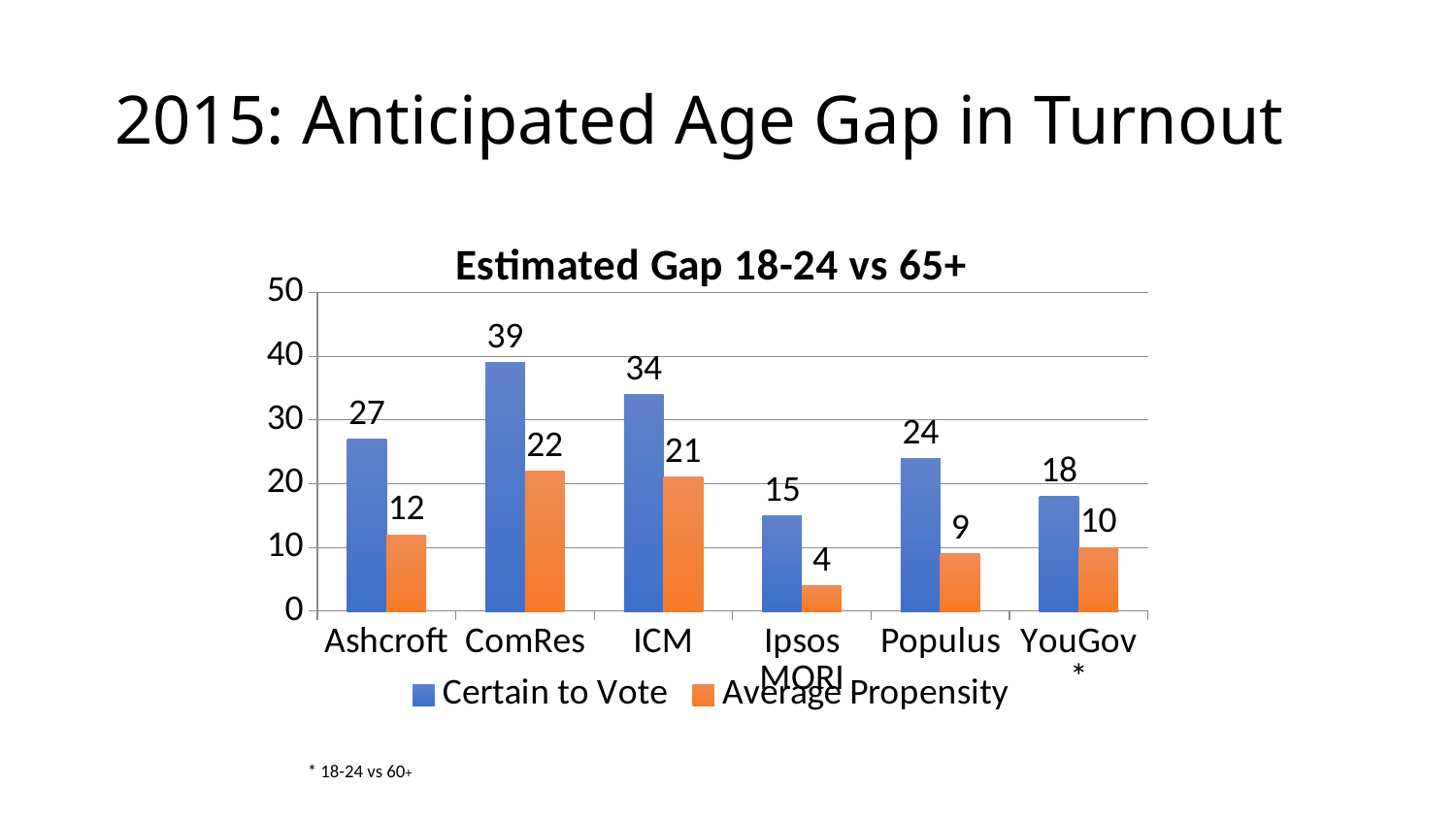
What is the Average Propensity value for Ipsos MORI? 4 What is the title of the chart? Estimated Gap 18-24 vs 65+ What is the Certain to Vote value for ComRes? 39 What is the difference between the Certain to Vote and Average Propensity values for ICM? 13 How many pollsters are shown on the x axis? 6 Which is larger, the Certain to Vote value for Ashcroft or for Populus? Ashcroft Is the Certain to Vote value for YouGov greater or less than 20? less How many series does the legend list? 2 What is the Average Propensity value for Populus? 9 Which pollster has the lowest Average Propensity value? Ipsos MORI What kind of chart is shown? bar chart Which pollster has the highest Certain to Vote value? ComRes